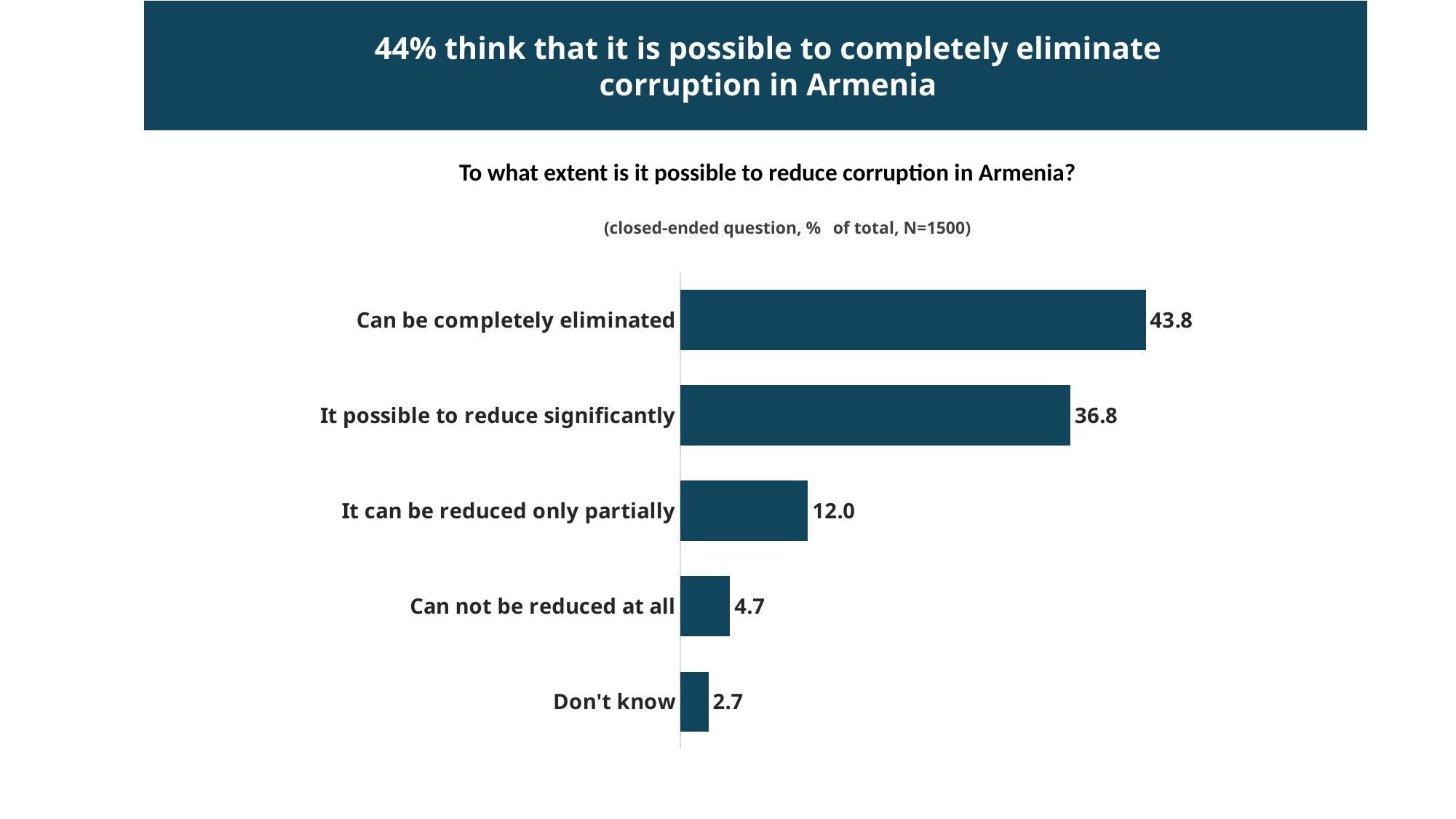
What is the value for "Don't know"? 2.7 What is the value for "It possible to reduce significantly"? 36.8 What is the difference between the values for "Can be completely eliminated" and "It possible to reduce significantly"? 7.0 What kind of chart is shown on the slide? Bar chart How many categories are shown in the chart? 5 Which category has the lowest value? Don't know What is the value for "It can be reduced only partially"? 12.0 What is the sample size (N) stated in the chart subtitle? N=1500 Which category has the highest value? Can be completely eliminated Which is larger: the value for "It can be reduced only partially" or the value for "Can not be reduced at all"? It can be reduced only partially What is the value for "Can not be reduced at all"? 4.7 What is the value for "Can be completely eliminated"? 43.8